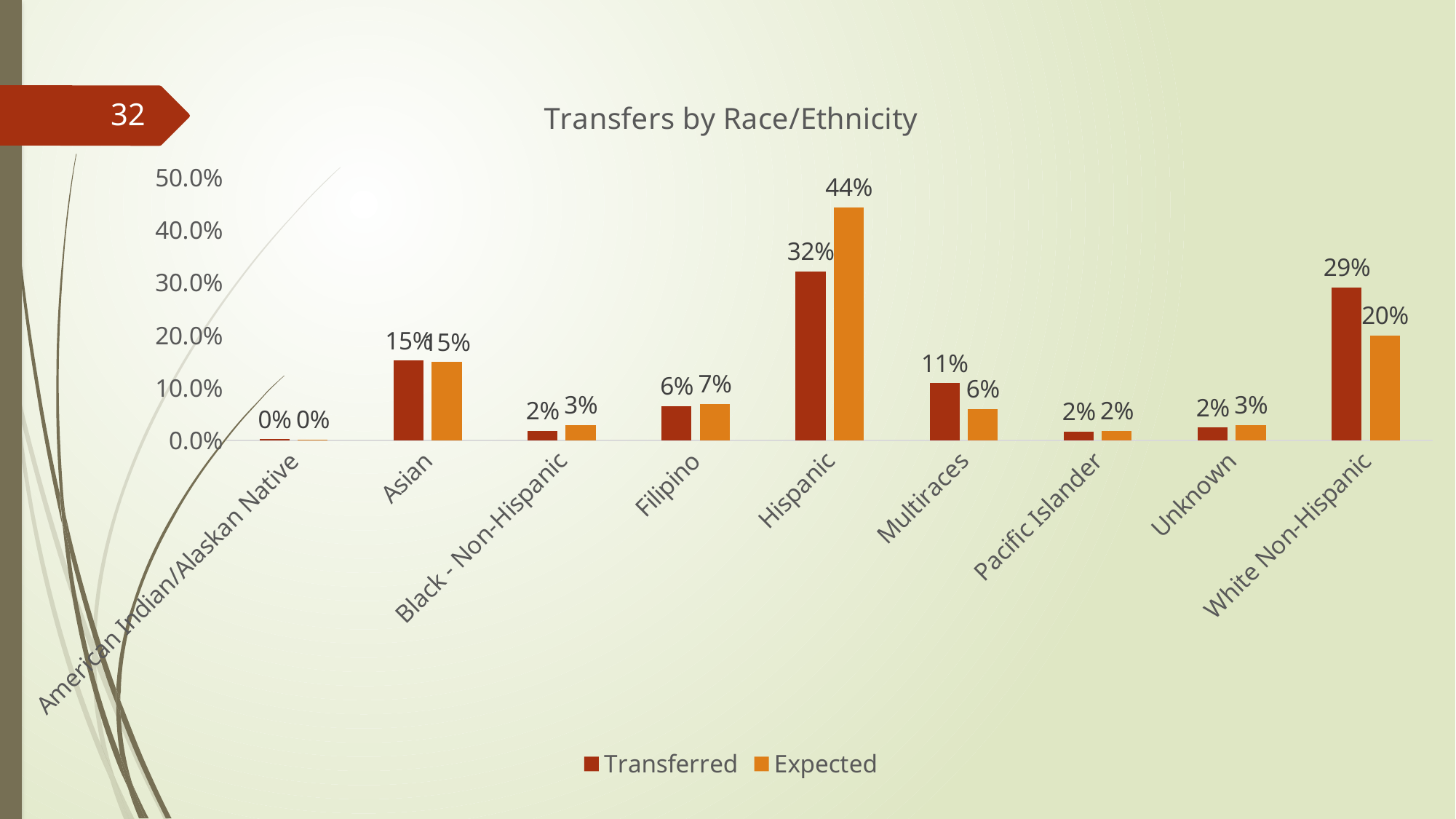
Which category has the lowest Transferred value? American Indian/Alaskan Native How many race/ethnicity categories are shown on the x axis? 9 What is the title of the chart? Transfers by Race/Ethnicity Is the Expected value for Hispanic greater or less than 40.0%? greater What kind of chart is shown? Bar chart What is the Transferred value for Multiraces? 11% Which category has the highest Expected value? Hispanic What is the Transferred value for Hispanic? 32% What is the Expected value for White Non-Hispanic? 20% How many series does the legend list? 2 What is the difference between the Expected and Transferred values for Hispanic? 12% Which is larger for White Non-Hispanic, the Transferred value or the Expected value? Transferred